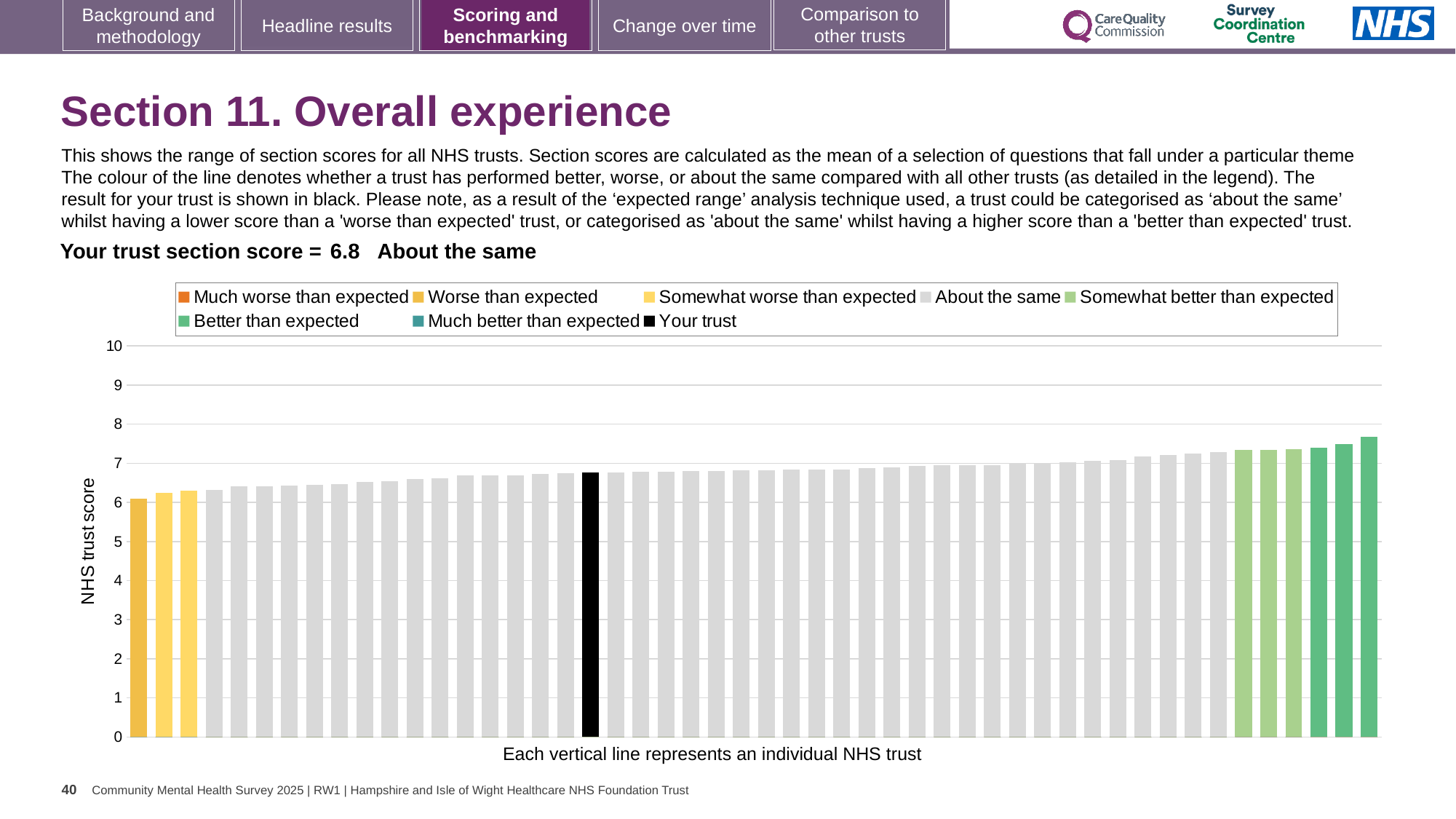
Is the value for your trust (the black bar) greater or less than 5? greater Which category is your trust placed in for Section 11? About the same What is your trust's section score for Section 11, Overall experience? 6.8 What is the label on the vertical axis of the chart? NHS trust score What colour is used for your trust's bar in the chart? black How many bars are shown in the 'Better than expected' colour? 3 What kind of chart is shown on the slide? bar chart How many entries does the chart legend list? 8 Do the bar values rise or fall from left to right across the chart? rise Is the value of the tallest bar on the chart greater or less than 7? greater Is the value of the leftmost bar on the chart greater or less than 7? less Is your trust's bar taller or shorter than the rightmost bar on the chart? shorter